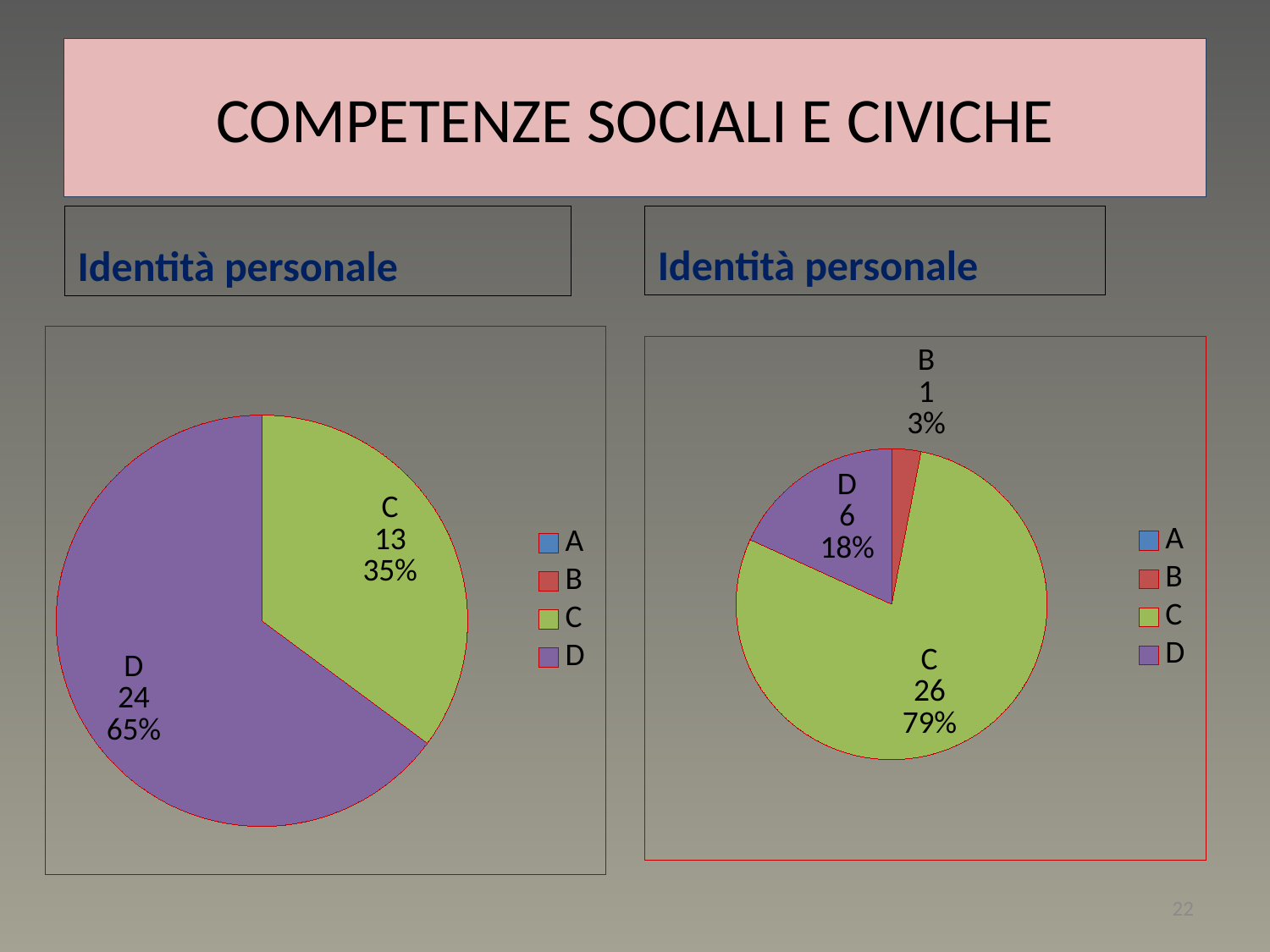
In the left pie chart, which category has the largest slice? D How many entries does the legend of the left chart list? 4 In the right pie chart, which category has the smallest slice? B What type of chart is shown on the left side of the slide? Pie chart In the left pie chart, what percentage share does C have? 35% In the right pie chart, which is larger, the value for D or the value for B? D In the left pie chart, what is the difference between the values for D and C? 11 In the right pie chart, what is the value for C? 26 In the right pie chart, what percentage share does D have? 18% In the left pie chart, what is the value for D? 24 How many slices are visible in the right pie chart? 3 In the right pie chart, what is the difference between the values for C and D? 20